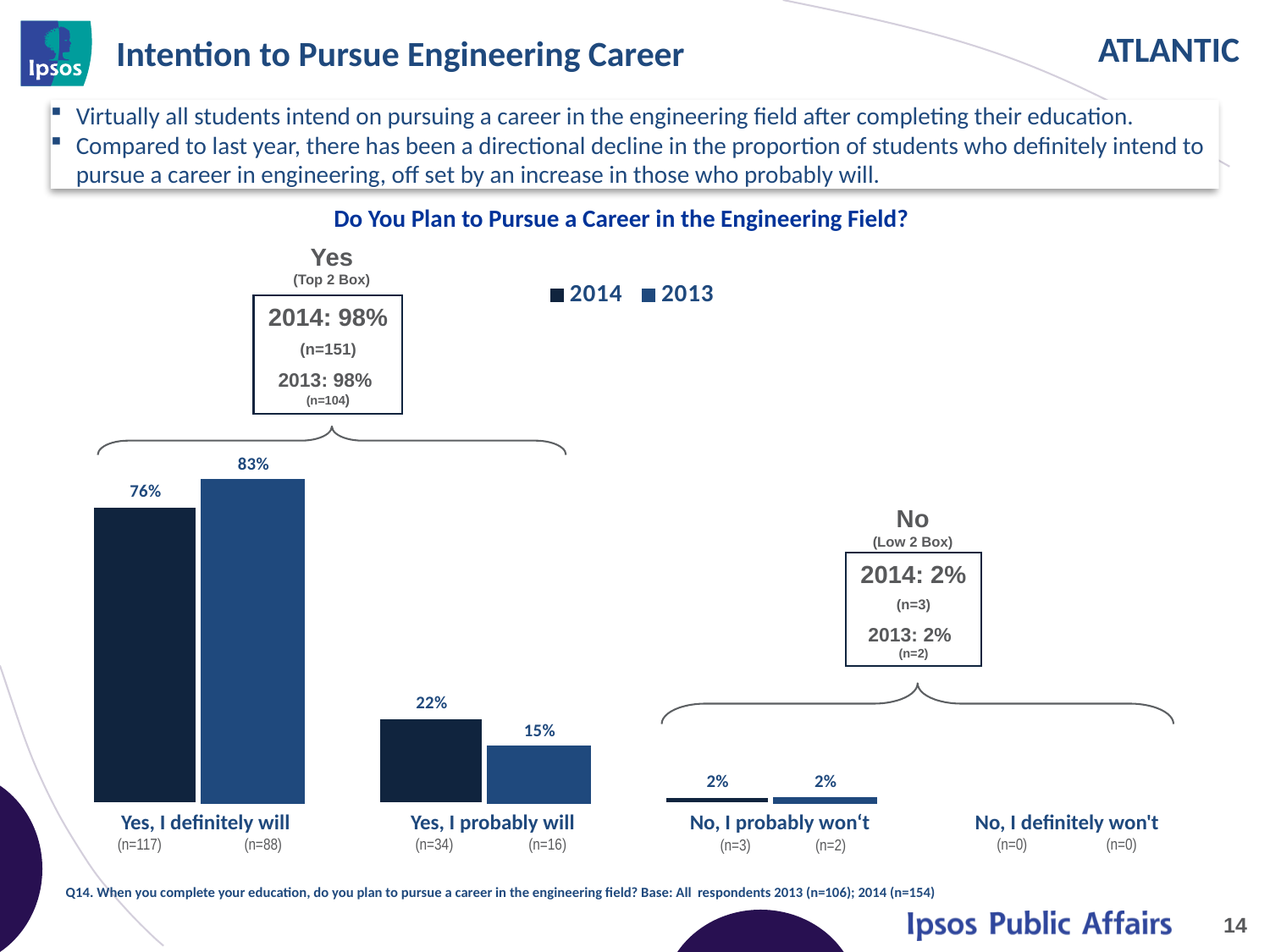
What is the difference between the 2013 and 2014 values for "Yes, I definitely will"? 7% What is the 2013 value for "Yes, I definitely will"? 83% What is the title of the chart? Do You Plan to Pursue a Career in the Engineering Field? What is the 2014 value for "No, I probably won't"? 2% What kind of chart is shown on the slide? Bar chart What is the 2014 value for "Yes, I definitely will"? 76% For "Yes, I probably will", which year has the larger value, 2014 or 2013? 2014 How many series does the legend list? 2 Which category has the highest 2014 value? Yes, I definitely will What is the 2014 value for "Yes, I probably will"? 22% What is the 2013 value for "Yes, I probably will"? 15% What is the difference between the 2014 and 2013 values for "Yes, I probably will"? 7%